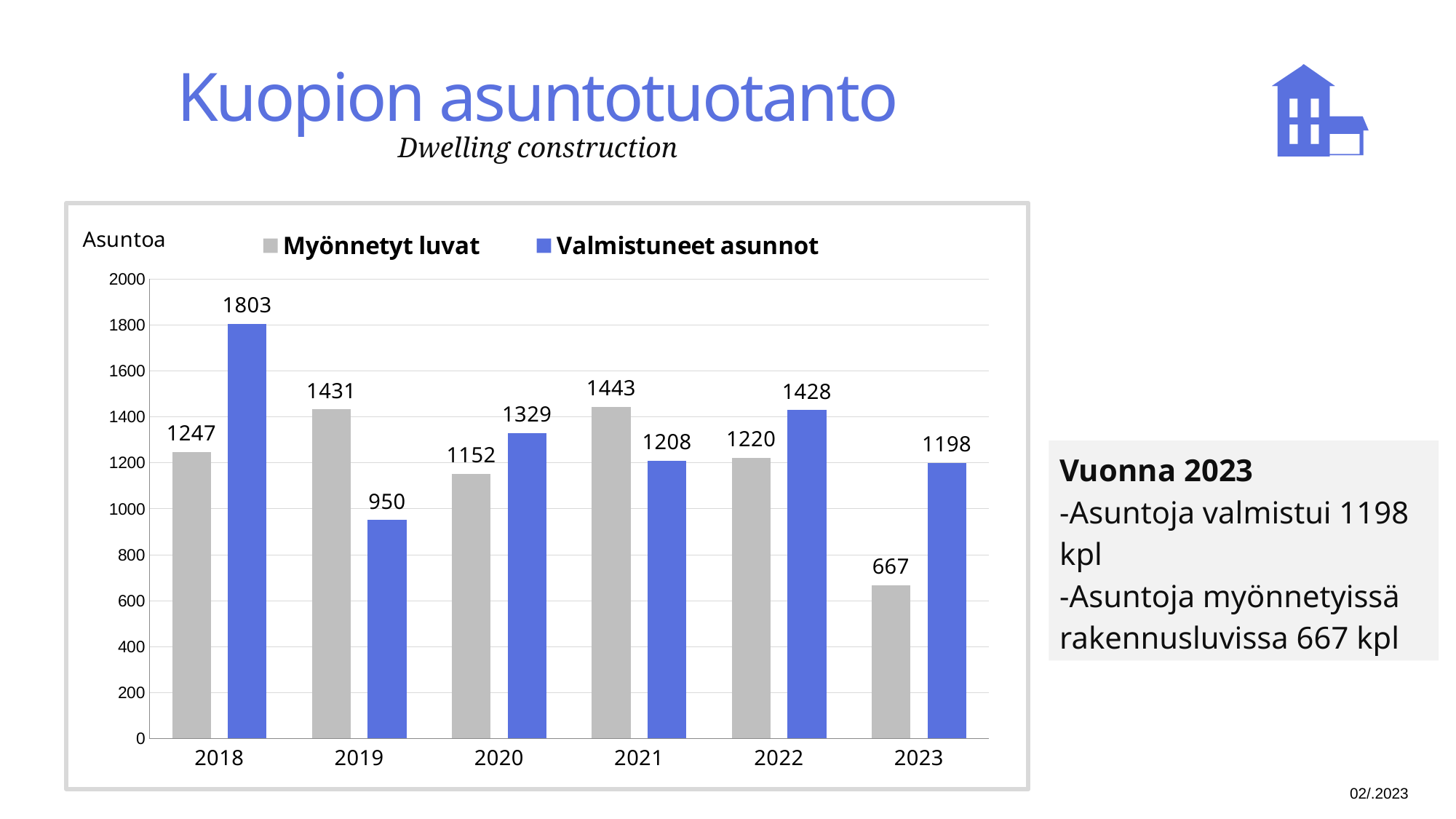
How many years are shown on the x axis? 6 What is the value of Valmistuneet asunnot for 2019? 950 What colour are the Valmistuneet asunnot bars? Blue What is the value of Myönnetyt luvat for 2018? 1247 What is the difference between Valmistuneet asunnot and Myönnetyt luvat in 2018? 556 Which year has the lowest value for Myönnetyt luvat? 2023 Which year has the highest value for Valmistuneet asunnot? 2018 In 2019, which is larger: Myönnetyt luvat or Valmistuneet asunnot? Myönnetyt luvat How many series does the legend list? 2 What is the value of Myönnetyt luvat for 2023? 667 What kind of chart is shown on the slide? Bar chart Is the value of Valmistuneet asunnot for 2022 greater or less than 1400? greater